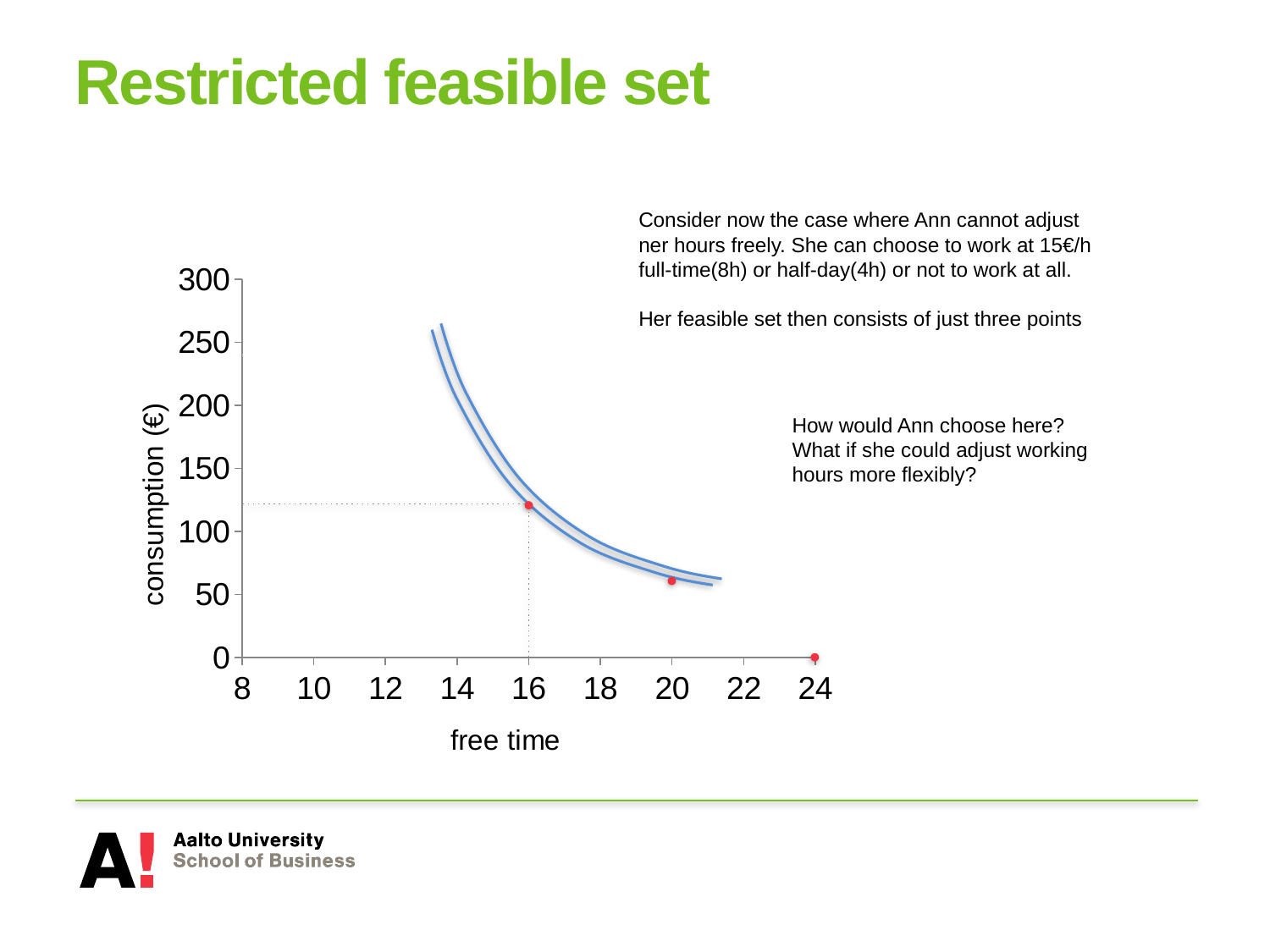
Is the consumption of the red point at 20 hours of free time greater or less than 50? greater Is the consumption of the red point at 20 hours of free time greater or less than 100? less At which free time value is the red point with the highest consumption? 16 What is the label of the horizontal axis? free time How many red points are plotted on the chart? 3 Which red point has higher consumption: the one at 16 hours of free time or the one at 20 hours? 16 hours As free time increases along the x axis, does the consumption of the red points rise or fall? fall What is the label of the vertical axis? consumption (€) Is the consumption of the red point at 16 hours of free time greater or less than 150? less What is the consumption value of the red point at 24 hours of free time? 0 At which free time value is the red point with the lowest consumption? 24